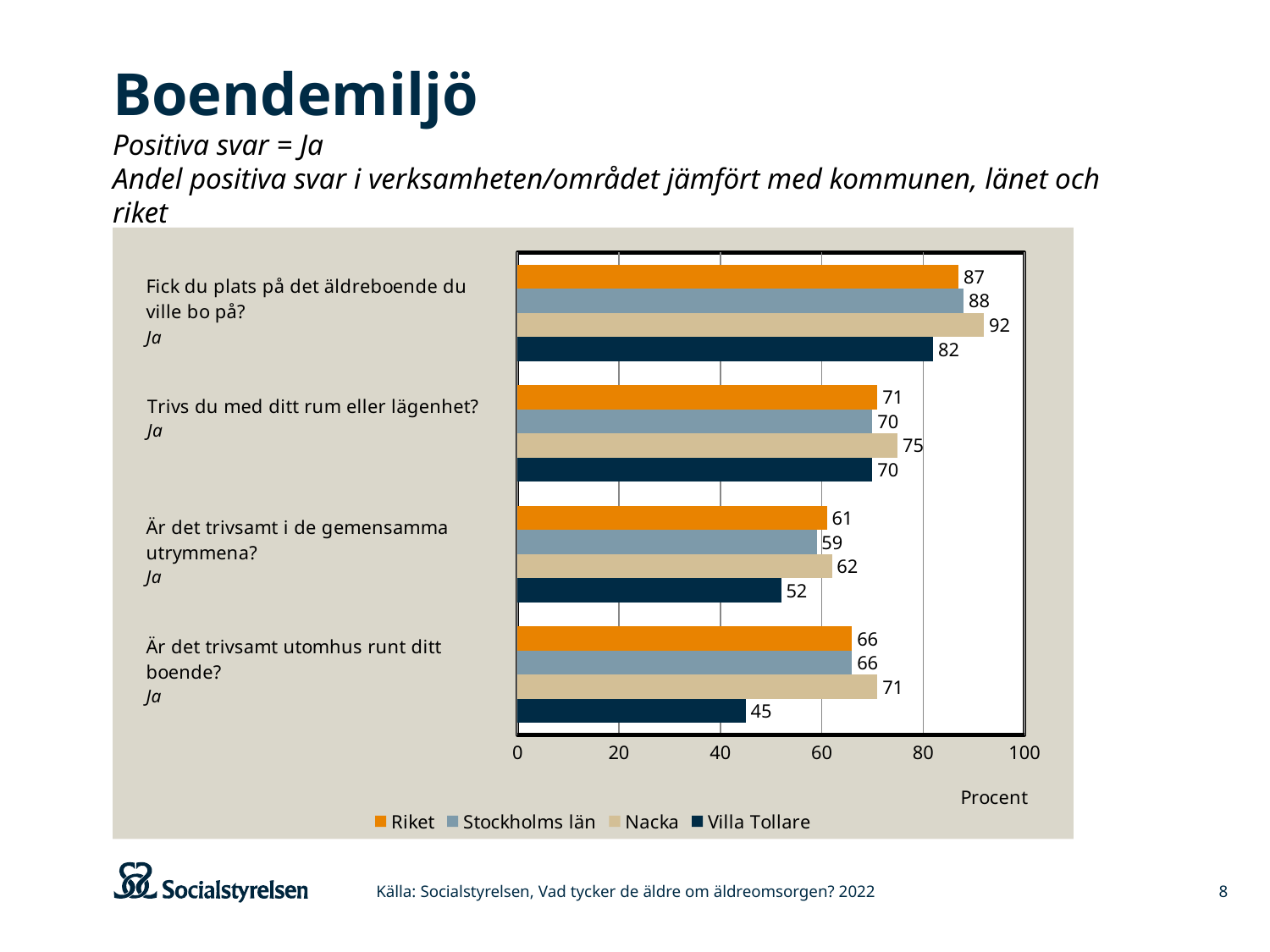
How many questions (categories) are shown in the chart? 4 What is the value for Nacka on the question "Fick du plats på det äldreboende du ville bo på?"? 92 What is the difference between the Nacka and Villa Tollare values on the question "Är det trivsamt utomhus runt ditt boende?"? 26 What is the value for Riket on the question "Trivs du med ditt rum eller lägenhet?"? 71 Which is larger on the question "Är det trivsamt i de gemensamma utrymmena?": the value for Riket or the value for Villa Tollare? Riket What is the value for Villa Tollare on the question "Är det trivsamt utomhus runt ditt boende?"? 45 How many series does the legend list? 4 Which series has the highest value on the question "Fick du plats på det äldreboende du ville bo på?"? Nacka Which series has the lowest value on the question "Är det trivsamt utomhus runt ditt boende?"? Villa Tollare What kind of chart is shown on the slide? Bar chart What is the label on the horizontal axis of the chart? Procent What is the value for Stockholms län on the question "Är det trivsamt i de gemensamma utrymmena?"? 59